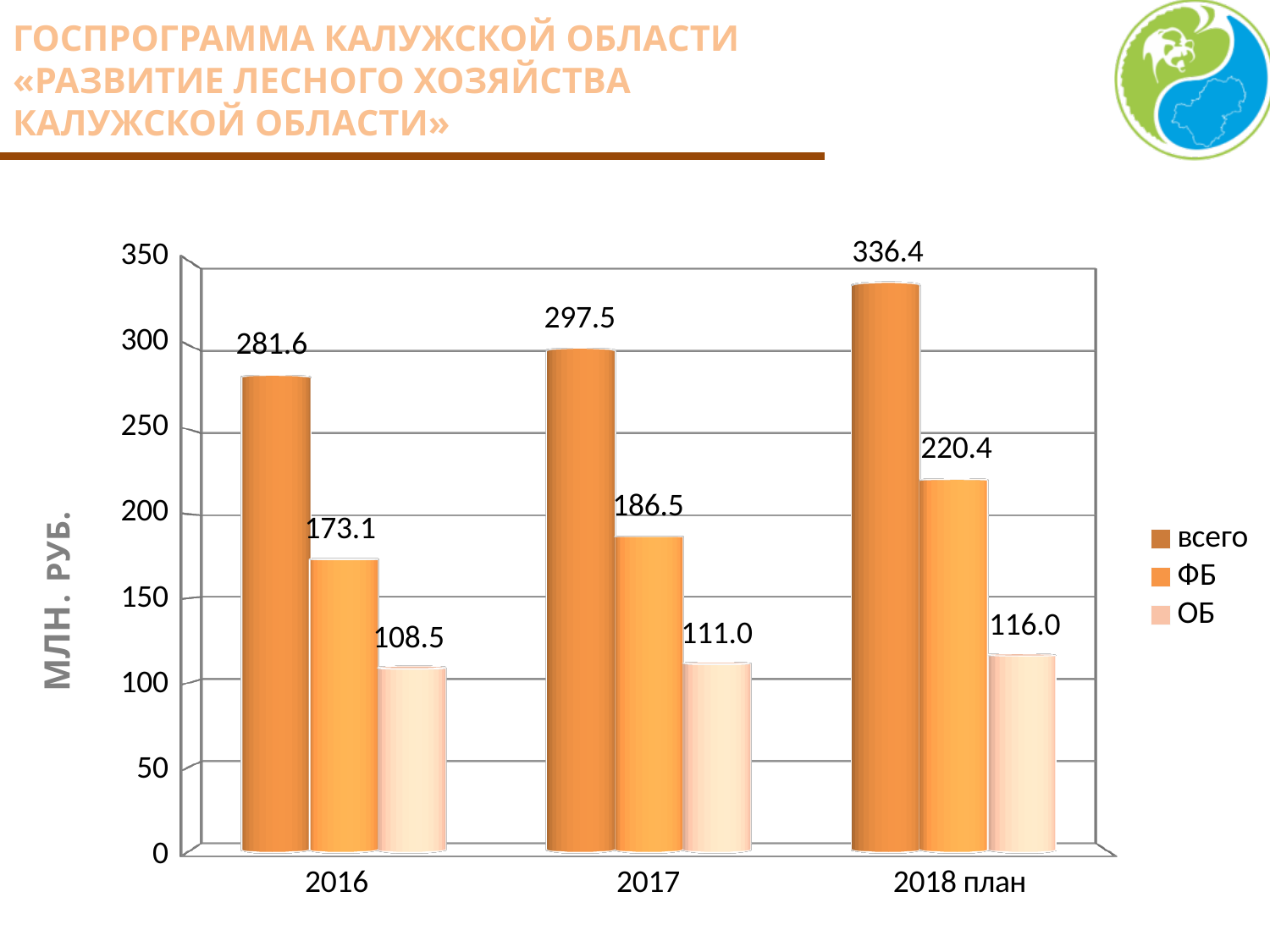
How many series does the legend list? 3 What is the value of всего for 2016? 281.6 What kind of chart is shown on the slide? bar chart What is the label on the vertical axis? МЛН. РУБ. Which is larger: ФБ for 2016 or ОБ for 2018 план? ФБ for 2016 What is the value of ФБ for 2017? 186.5 Which year has the lowest value for ОБ? 2016 What is the value of ОБ for 2018 план? 116.0 How many categories are shown on the x axis? 3 Which year has the highest value for всего? 2018 план Do the values for ФБ rise or fall from 2016 to 2018 план? rise What is the difference between всего for 2018 план and всего for 2017? 38.9